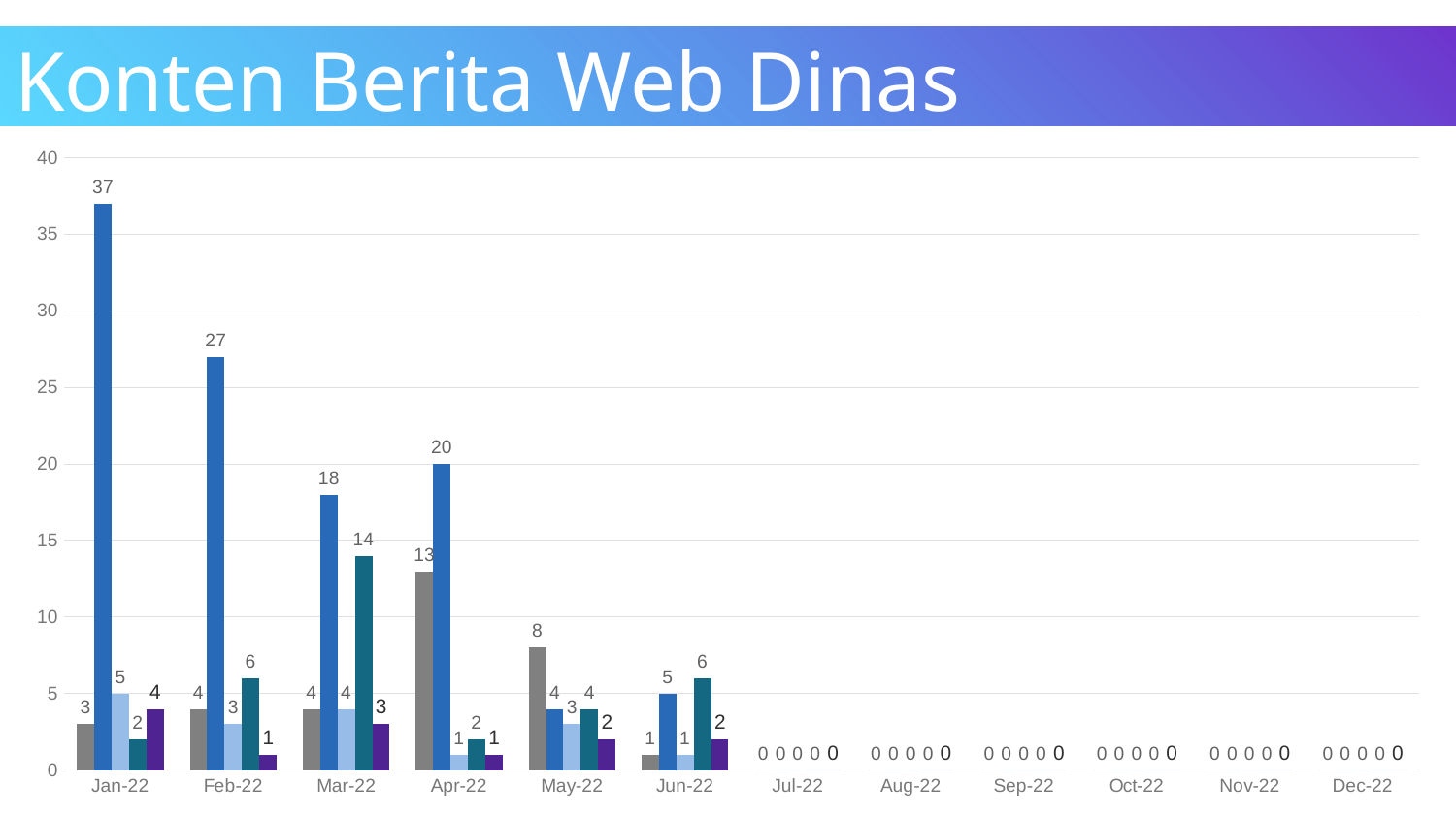
What is the title of the chart? Konten Berita Web Dinas Which is larger in Apr-22: the grey bar or the dark blue bar? the dark blue bar Which month has the highest single bar value? Jan-22 What is the value of the grey bar in Apr-22? 13 What type of chart is shown on the slide? bar chart What is the value of the dark blue bar in Feb-22? 27 What is the value of the teal bar in Mar-22? 14 How many months are shown on the x axis? 12 Does the dark blue bar value rise or fall from Jan-22 to Mar-22? fall What is the value of the tallest bar in Jan-22? 37 What is the difference between the dark blue bar in Jan-22 (37) and the dark blue bar in Feb-22 (27)? 10 What value do all bars show for Jul-22 through Dec-22? 0